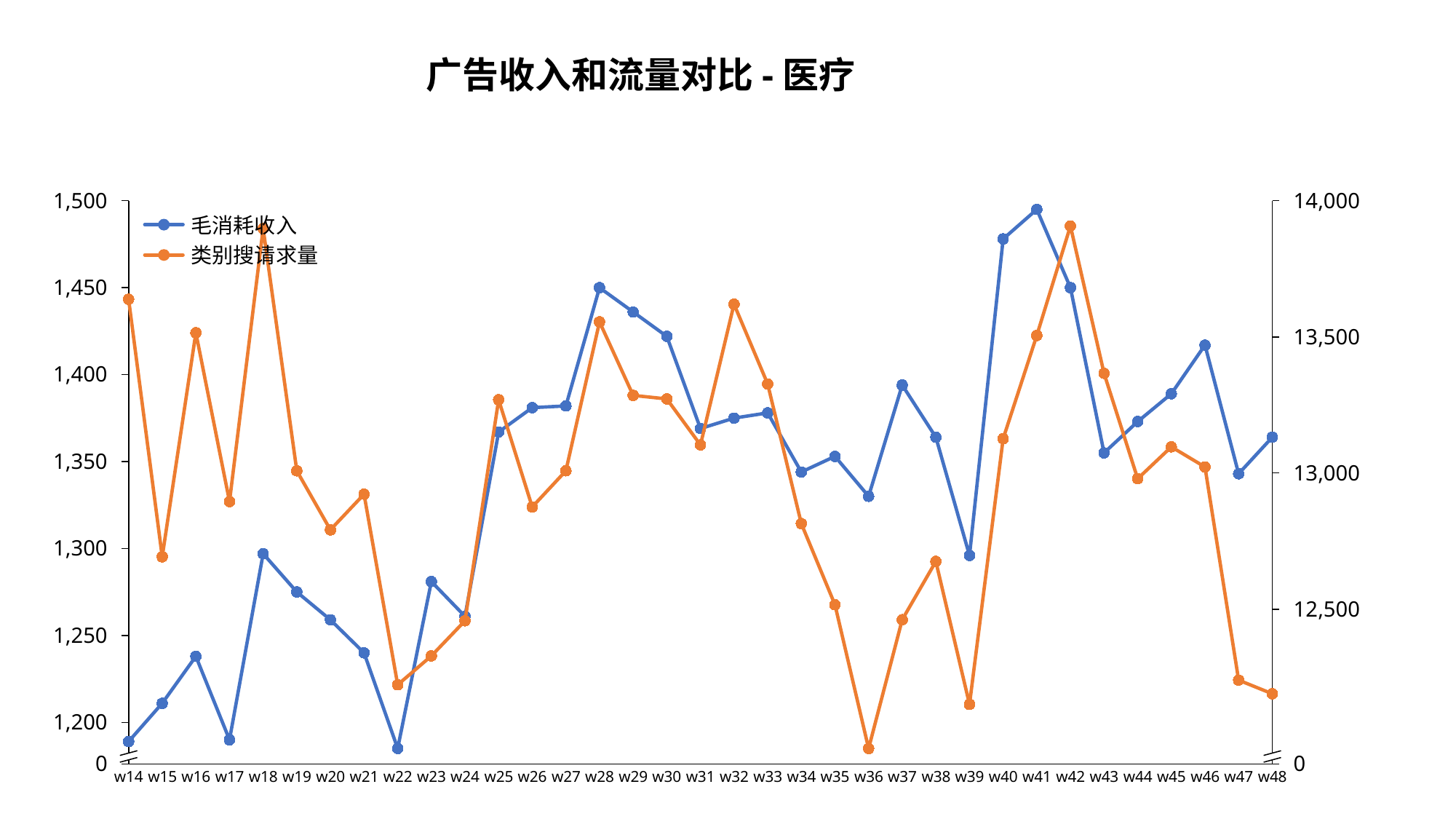
Is the value of 类别搜请求量 for w42 greater or less than 13,500? greater Does 类别搜请求量 rise or fall from w42 to w47? fall How many weeks are plotted along the x axis? 35 In which week is 类别搜请求量 lowest? w36 Is the value of 毛消耗收入 for w22 greater or less than 1,200? less Is the value of 类别搜请求量 for w36 greater or less than 12,500? less In which week is 毛消耗收入 highest? w41 What kind of chart is shown on the slide? line chart What is the title of the chart? 广告收入和流量对比 - 医疗 How many series does the legend list? 2 Which series is drawn in orange? 类别搜请求量